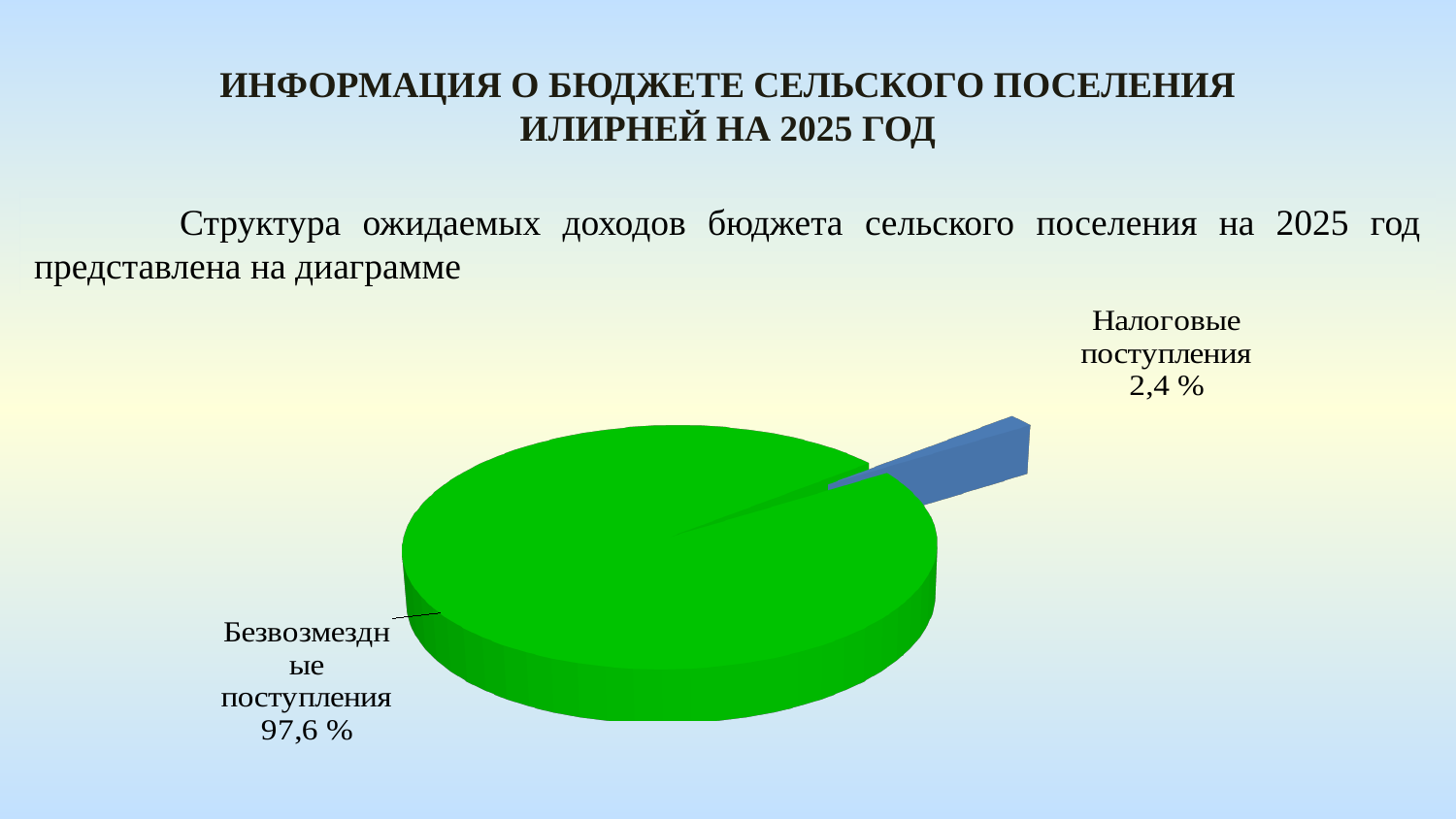
What colour is the slice for Налоговые поступления? blue What colour is the slice for Безвозмездные поступления? green Which is larger: Налоговые поступления or Безвозмездные поступления? Безвозмездные поступления Which category has the largest slice of the pie? Безвозмездные поступления How many slices does the pie chart have? 2 What share of the pie does Безвозмездные поступления have? 97,6 % What is the difference in percentage points between Безвозмездные поступления and Налоговые поступления? 95,2 What kind of chart is shown on the slide? pie chart What share of the pie does Налоговые поступления have? 2,4 % Which category has the smallest slice of the pie? Налоговые поступления